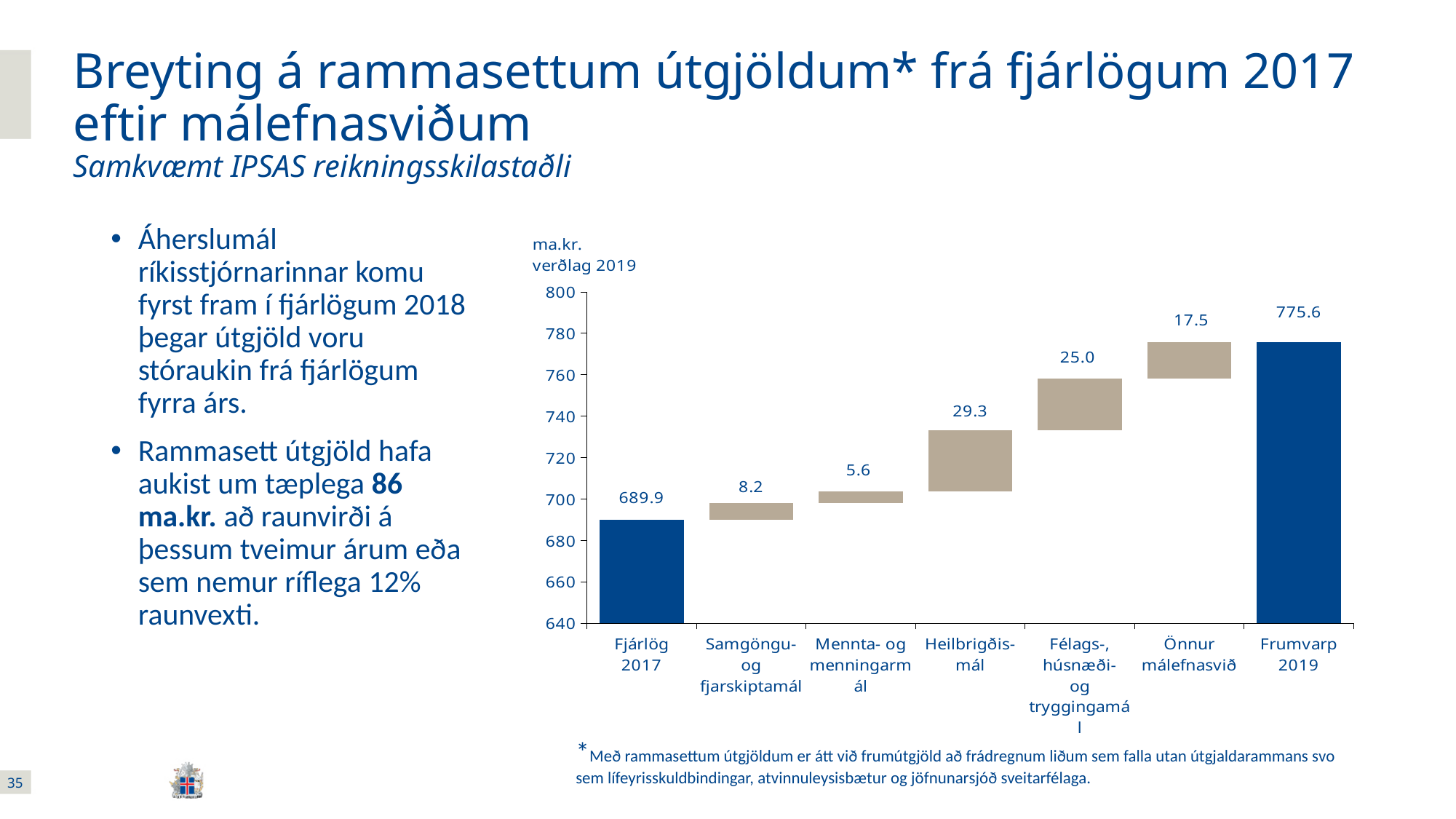
What is the value labelled on the Heilbrigðismál bar? 29.3 What is the difference between the Frumvarp 2019 value and the Fjárlög 2017 value? 85.7 Which category has the smallest labelled value on the chart? Mennta- og menningarmál What unit and price level are stated above the chart's y axis? ma.kr. verðlag 2019 What is the value shown for Frumvarp 2019? 775.6 Which has a larger labelled value, Samgöngu- og fjarskiptamál or Félags-, húsnæðis- og tryggingamál? Félags-, húsnæðis- og tryggingamál Is the value for Fjárlög 2017 greater or less than 700? less Which of the intermediate categories (between Fjárlög 2017 and Frumvarp 2019) has the largest labelled value? Heilbrigðismál How many categories are shown on the x axis of the chart? 7 What is the value shown for Fjárlög 2017? 689.9 What kind of chart is shown on the slide? bar chart What is the value labelled on the Önnur málefnasvið bar? 17.5